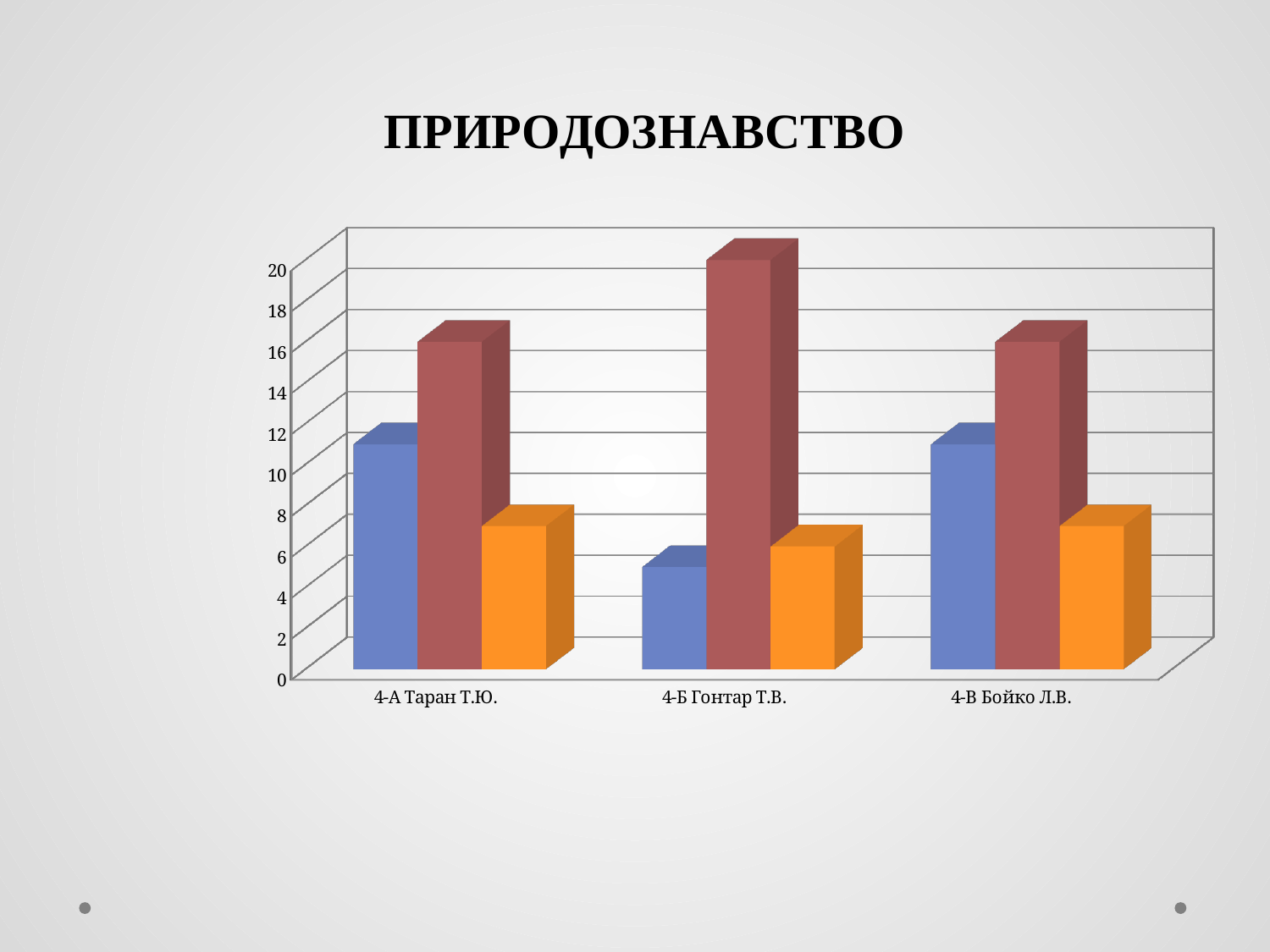
What kind of chart is shown on the slide? bar chart Which category has the shortest blue bar? 4-Б Гонтар Т.В. Is the value of the blue bar for 4-Б Гонтар Т.В. greater or less than 8? less How many bars are plotted for each category? 3 What is the title of the chart? ПРИРОДОЗНАВСТВО Is the value of the red bar for 4-Б Гонтар Т.В. greater or less than 18? greater For 4-А Таран Т.Ю., which is larger: the blue bar or the orange bar? the blue bar Which category has the tallest red bar? 4-Б Гонтар Т.В. How many categories are shown on the x axis? 3 For 4-Б Гонтар Т.В., which is larger: the red bar or the blue bar? the red bar Is the value of the red bar for 4-А Таран Т.Ю. greater or less than 14? greater